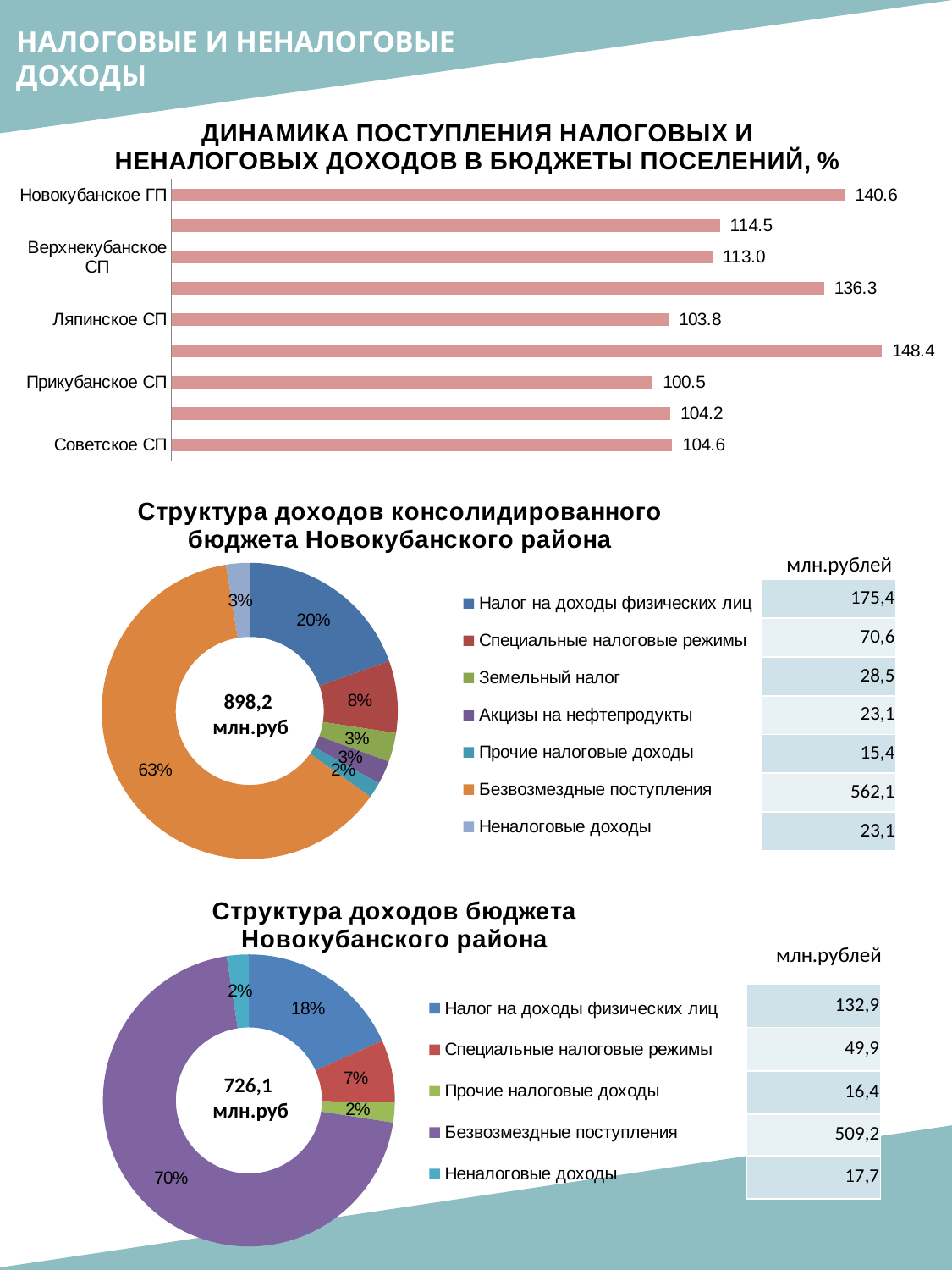
What kind of chart is 'Динамика поступления налоговых и неналоговых доходов в бюджеты поселений, %'? bar chart In the bar chart 'Динамика поступления налоговых и неналоговых доходов в бюджеты поселений, %', what is the difference between the values for Новокубанское ГП and Ляпинское СП? 36.8 In the bar chart 'Динамика поступления налоговых и неналоговых доходов в бюджеты поселений, %', which is larger: the value for Верхнекубанское СП or the value for Советское СП? Верхнекубанское СП In the bar chart 'Динамика поступления налоговых и неналоговых доходов в бюджеты поселений, %', what is the value for Прикубанское СП? 100.5 In the bar chart 'Динамика поступления налоговых и неналоговых доходов в бюджеты поселений, %', what is the largest value shown on any bar? 148.4 In the chart 'Структура доходов бюджета Новокубанского района', which category has the largest share? Безвозмездные поступления In the bar chart 'Динамика поступления налоговых и неналоговых доходов в бюджеты поселений, %', what is the value for Новокубанское ГП? 140.6 In the chart 'Структура доходов консолидированного бюджета Новокубанского района', what is the value in млн.рублей for Налог на доходы физических лиц? 175,4 How many categories does the legend of 'Структура доходов консолидированного бюджета Новокубанского района' list? 7 In the chart 'Структура доходов консолидированного бюджета Новокубанского района', what share does Безвозмездные поступления have? 63% In the chart 'Структура доходов бюджета Новокубанского района', what total is shown in the centre of the donut? 726,1 млн.руб In the bar chart 'Динамика поступления налоговых и неналоговых доходов в бюджеты поселений, %', how many bars are plotted? 9